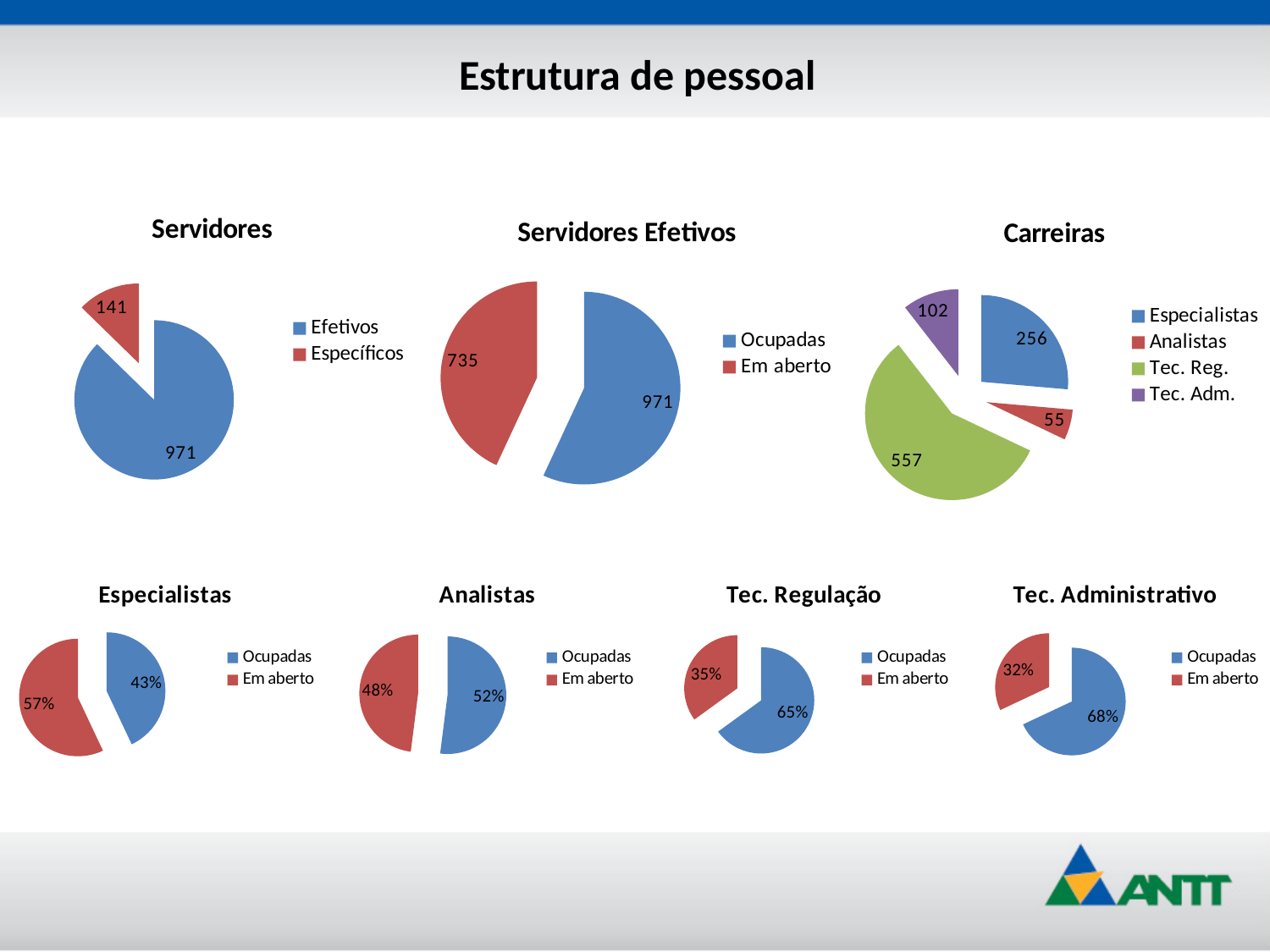
In the 'Servidores' chart, what is the value for Específicos? 141 In the 'Especialistas' chart, what share of the pie is Em aberto? 57% How many categories does the 'Carreiras' chart show? 4 In the 'Servidores' chart, what is the value for Efetivos? 971 What type of chart is the 'Analistas' chart? Pie chart In the 'Carreiras' chart, what is the difference between Tec. Reg. and Tec. Adm.? 455 In the 'Carreiras' chart, which category has the largest value? Tec. Reg. In the 'Carreiras' chart, which category has the smallest value? Analistas In the 'Servidores Efetivos' chart, what is the value for Em aberto? 735 In the 'Servidores Efetivos' chart, what is the difference between Ocupadas and Em aberto? 236 In the 'Carreiras' chart, what is the value for Especialistas? 256 In the 'Tec. Administrativo' chart, which is larger, Ocupadas or Em aberto? Ocupadas